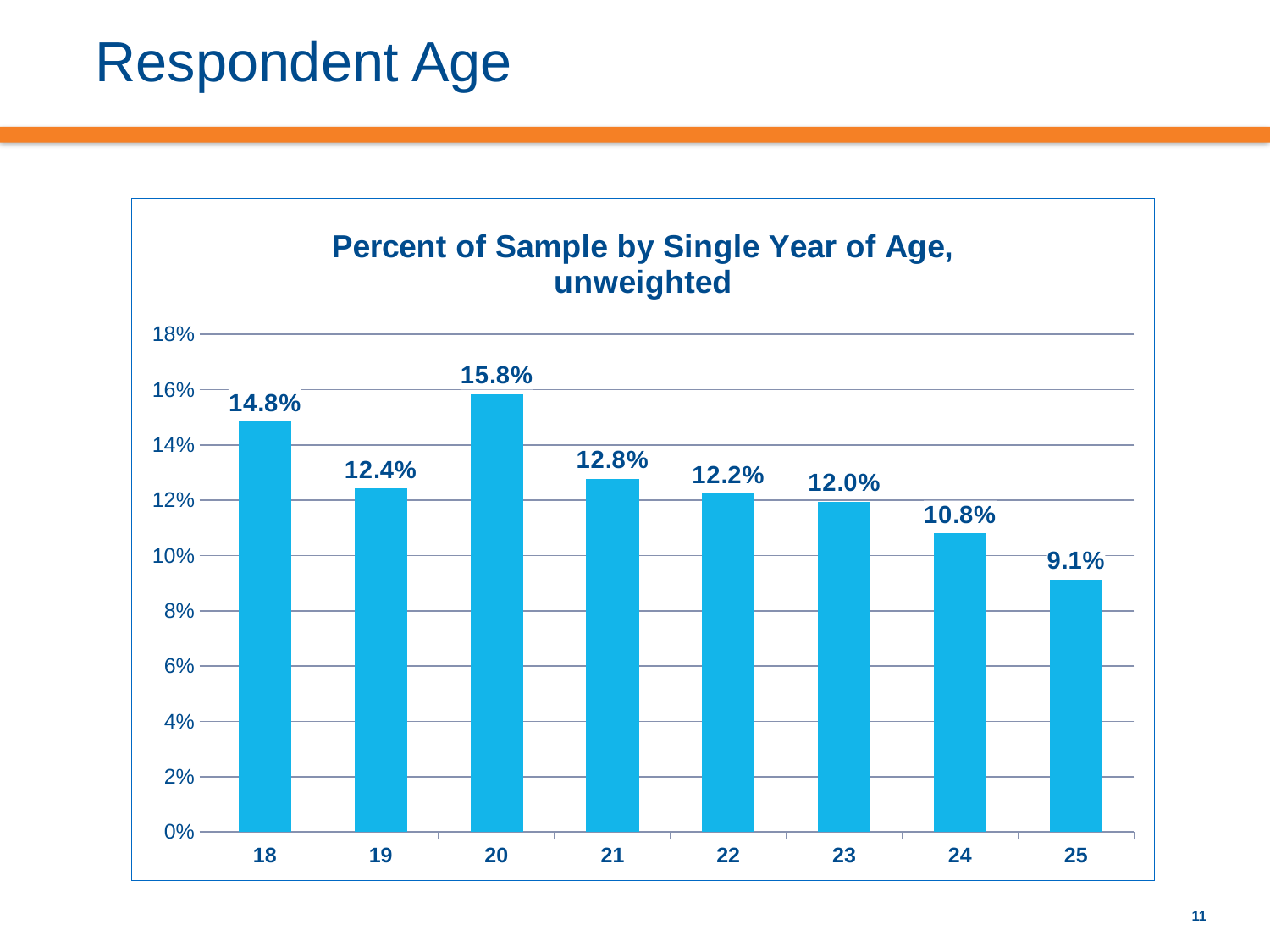
What percent of the sample is age 22? 12.2% What is the title of the chart? Percent of Sample by Single Year of Age, unweighted What kind of chart is shown on the slide? bar chart Which age has the highest percent of the sample? 20 What percent of the sample is age 25? 9.1% Which age has the lowest percent of the sample? 25 How many single-year age categories are shown on the x axis? 8 What percent of the sample is age 20? 15.8% Is the value for age 24 greater or less than 12%? less What is the difference in percent of sample between age 20 and age 25? 6.7% What is the difference in percent of sample between age 18 and age 19? 2.4% Which age has a larger share of the sample, 18 or 21? 18